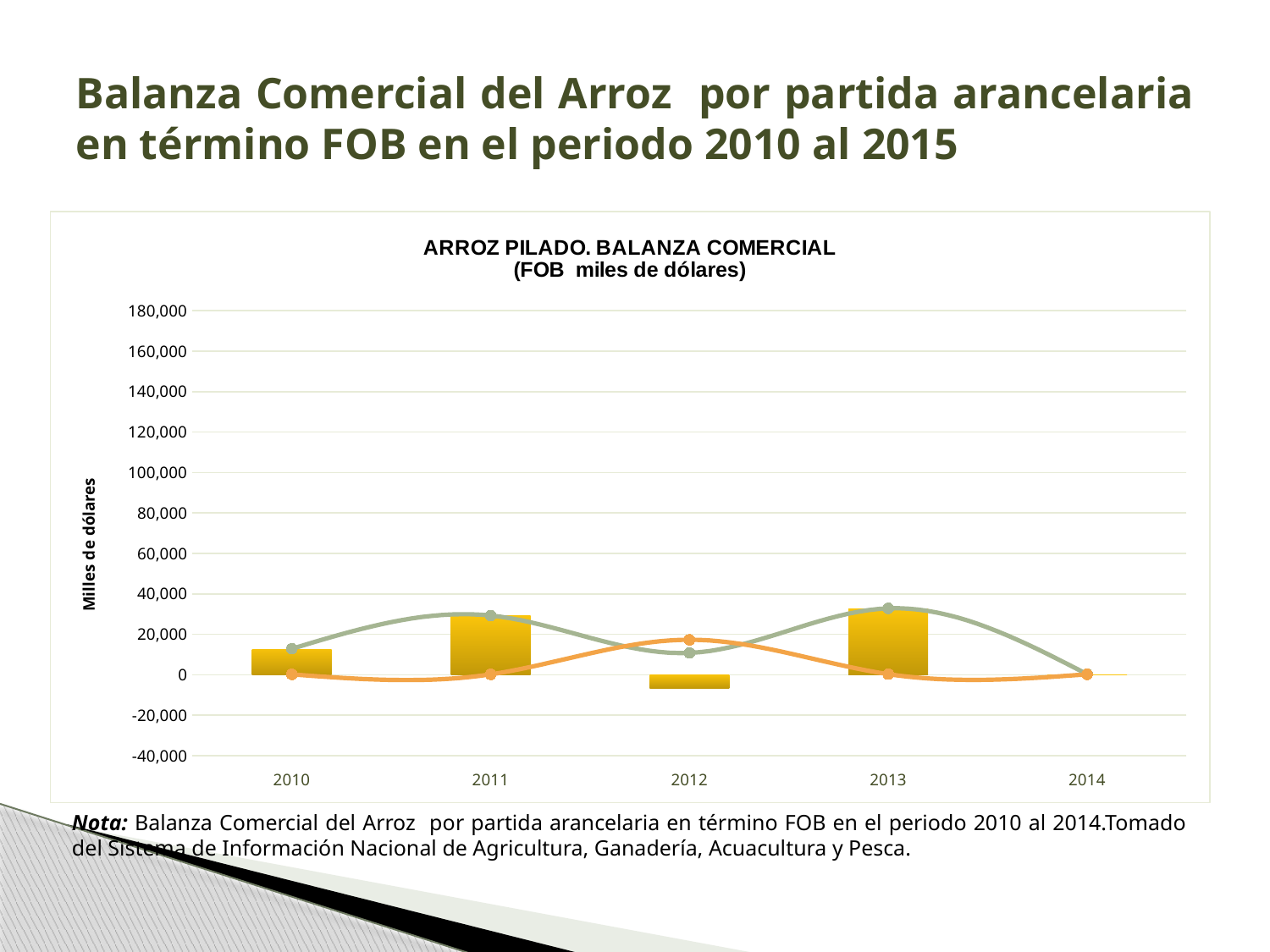
Which year has a larger bar value, 2010 or 2011? 2011 Is the bar value for 2013 greater or less than 40,000? less Which year is the only one with a negative bar value? 2012 Is the bar value for 2010 greater or less than 20,000? less Is the bar value for 2011 greater or less than 20,000? greater What is the label on the vertical axis of the chart? Milles de dólares Which year has the lowest bar in the chart? 2012 How many years are shown on the x axis of the chart? 5 Which year has the tallest bar in the chart? 2013 What is the title of the chart? ARROZ PILADO. BALANZA COMERCIAL (FOB miles de dólares) Does the bar value rise or fall from 2010 to 2011? rise